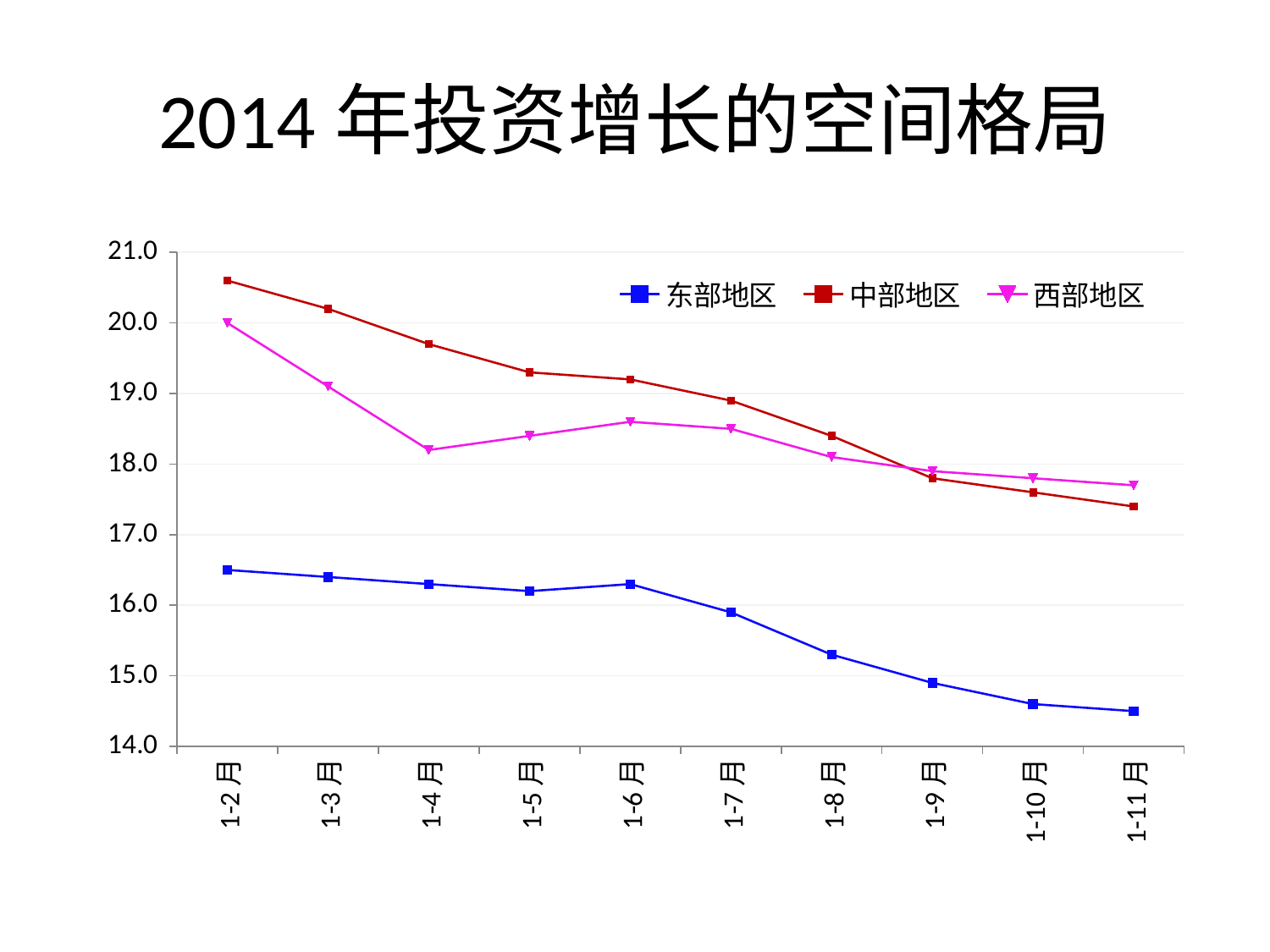
Is the value for 西部地区 at 1-6月 greater or less than 18.0? greater How many points are plotted along the x axis for each series? 10 What is the title of the slide? 2014 年投资增长的空间格局 At 1-11月, which is higher: 西部地区 or 中部地区? 西部地区 At 1-2月, which is higher: 中部地区 or 西部地区? 中部地区 How many series does the legend list? 3 Does the value for 东部地区 rise or fall from 1-2月 to 1-11月? fall Which series has the lowest values across all months? 东部地区 Is the value for 东部地区 at 1-11月 greater or less than 15.0? less What kind of chart is shown on the slide? line chart Is the value for 中部地区 at 1-2月 greater or less than 20.0? greater Which series has the highest value at 1-2月? 中部地区